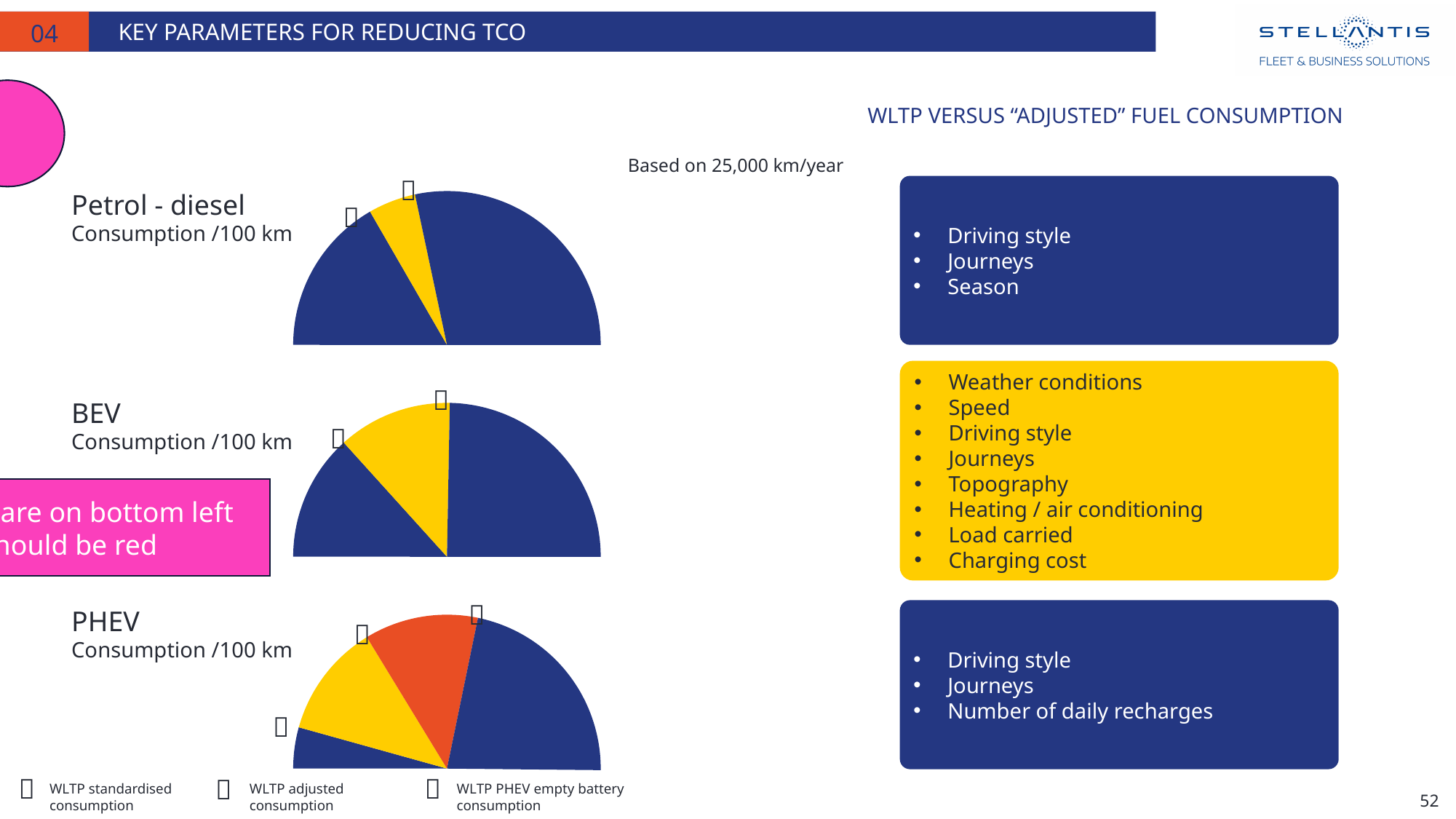
What kind of chart is used for the Petrol - diesel consumption figure? Pie chart (half-pie / semicircle) In the Petrol - diesel chart, which segment is larger, the blue one or the yellow one? Blue Is the yellow segment larger in the BEV chart or in the Petrol - diesel chart? BEV Is the yellow segment larger in the PHEV chart or in the Petrol - diesel chart? PHEV How many semicircular consumption charts are shown on the slide? 3 Which consumption chart has the smallest yellow (WLTP adjusted consumption) segment? Petrol - diesel Which of the three consumption charts contains a red segment? PHEV How many entries does the legend at the bottom of the slide list? 3 What is the title of the chart section on the right side of the slide? WLTP VERSUS "ADJUSTED" FUEL CONSUMPTION What annual distance are the consumption charts based on? 25,000 km/year